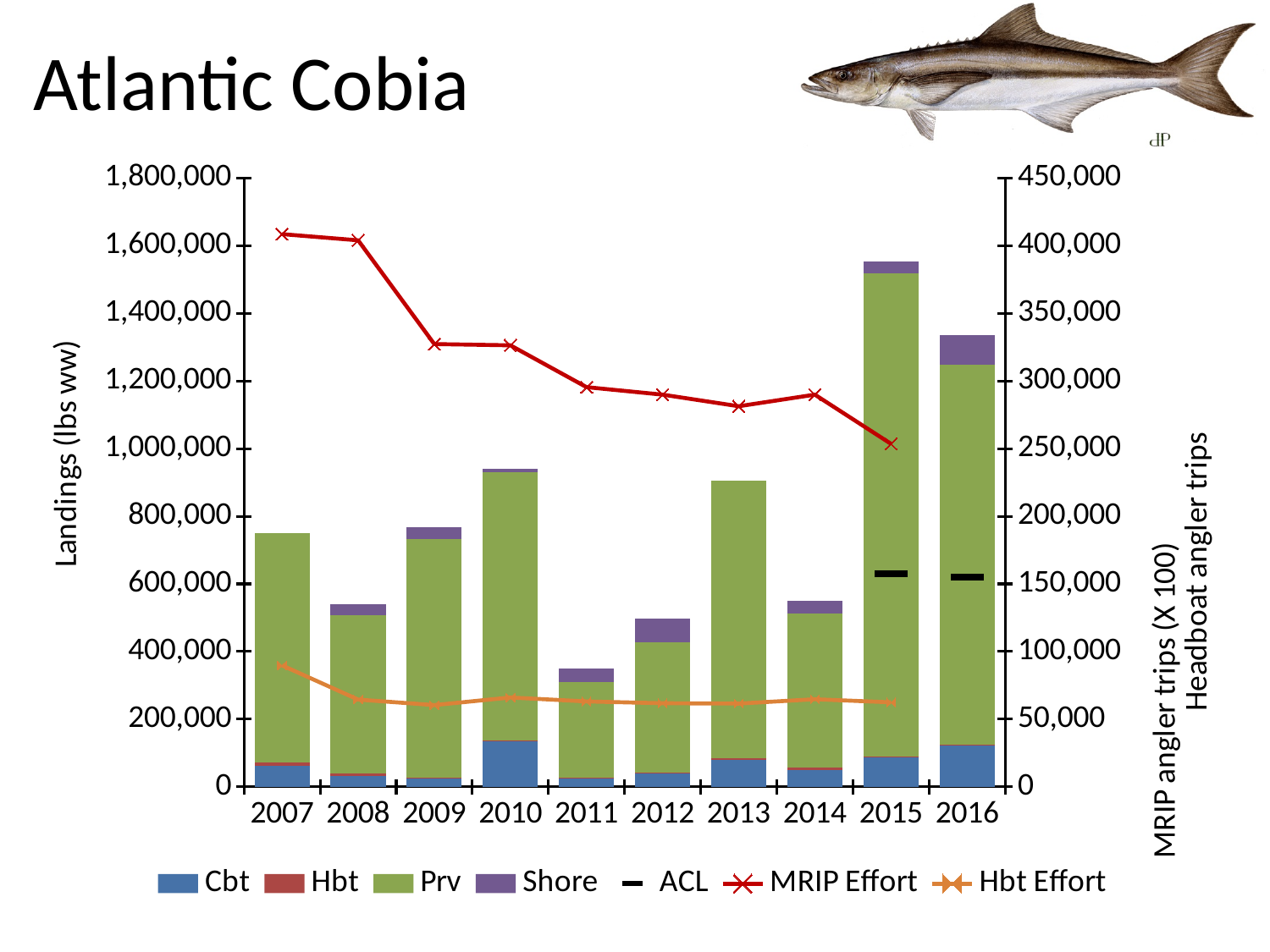
Is the total landings bar for 2011 greater or less than 400,000? less Does the MRIP Effort line generally rise or fall from 2007 to 2015? fall How many years are shown along the x axis? 10 How many series does the legend list? 7 What is the label of the left vertical axis? Landings (lbs ww) Which year has the lowest MRIP Effort value? 2015 What kind of chart is shown on the slide? bar chart with line series Which year has the tallest stacked landings bar? 2015 Which year has a taller total landings bar, 2007 or 2008? 2007 Which year has the shortest stacked landings bar? 2011 Is the MRIP Effort value for 2015 greater or less than 300,000 on the right axis? less Is the total landings bar for 2015 greater or less than 1,400,000? greater